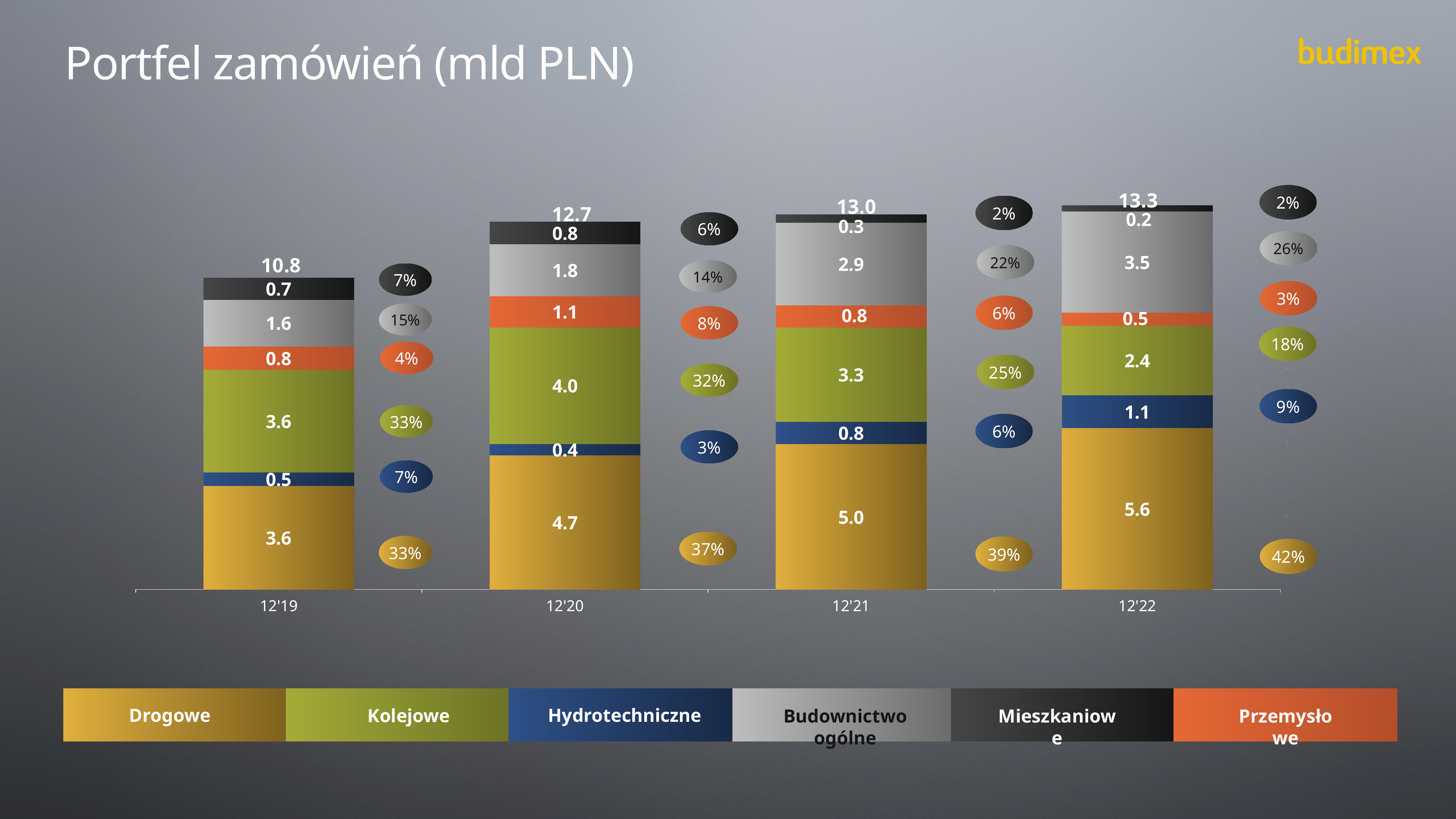
How many series does the legend list? 6 Which period has the lowest total order portfolio? 12'19 What is the value of the Kolejowe segment for 12'19? 3.6 What percentage share does the Drogowe segment have in 12'22? 42% What is the value of the Drogowe segment for 12'20? 4.7 What is the value of the Budownictwo ogólne segment for 12'21? 2.9 Which period has the highest total order portfolio? 12'22 What is the difference between the Drogowe values for 12'22 and 12'19? 2.0 What is the total order portfolio (Portfel zamówień) for 12'22? 13.3 What type of chart is shown on the slide? Stacked bar chart Which is larger, the Kolejowe segment for 12'20 or the Kolejowe segment for 12'22? 12'20 How many periods are shown on the x axis? 4